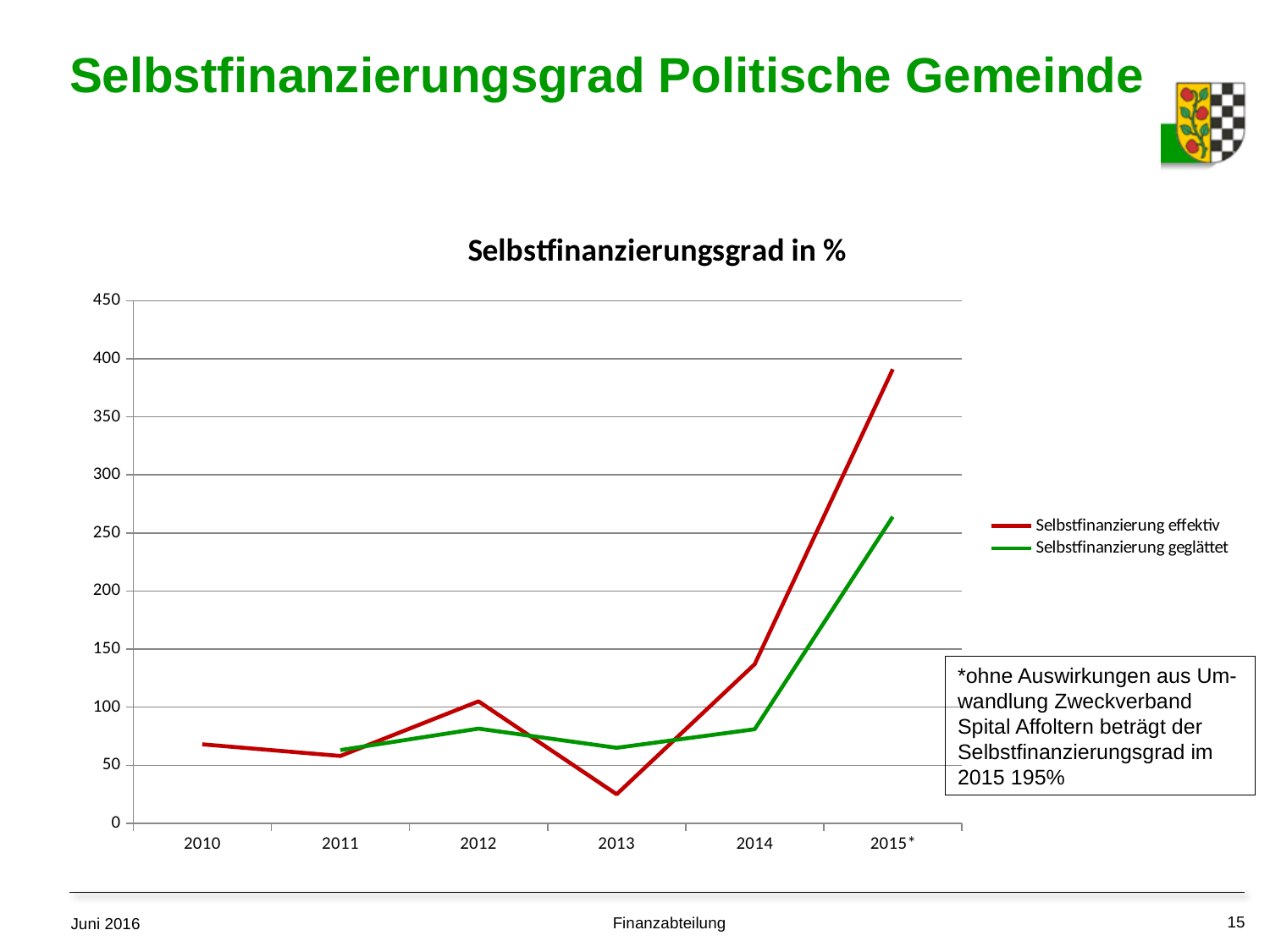
Is the value for Selbstfinanzierung geglättet in 2012 greater or less than 100? less How many series does the legend list? 2 What kind of chart is shown on the slide? line chart Is the value for Selbstfinanzierung effektiv in 2013 greater or less than 50? less In which year does the Selbstfinanzierung effektiv line reach its lowest value? 2013 In which year does the Selbstfinanzierung effektiv line reach its highest value? 2015* Is the value for Selbstfinanzierung geglättet in 2015* greater or less than 200? greater Does the Selbstfinanzierung effektiv line rise or fall from 2013 to 2015*? rise How many years are shown on the x axis? 6 In 2013, which series has the larger value, Selbstfinanzierung effektiv or Selbstfinanzierung geglättet? Selbstfinanzierung geglättet In 2015*, which series has the larger value, Selbstfinanzierung effektiv or Selbstfinanzierung geglättet? Selbstfinanzierung effektiv